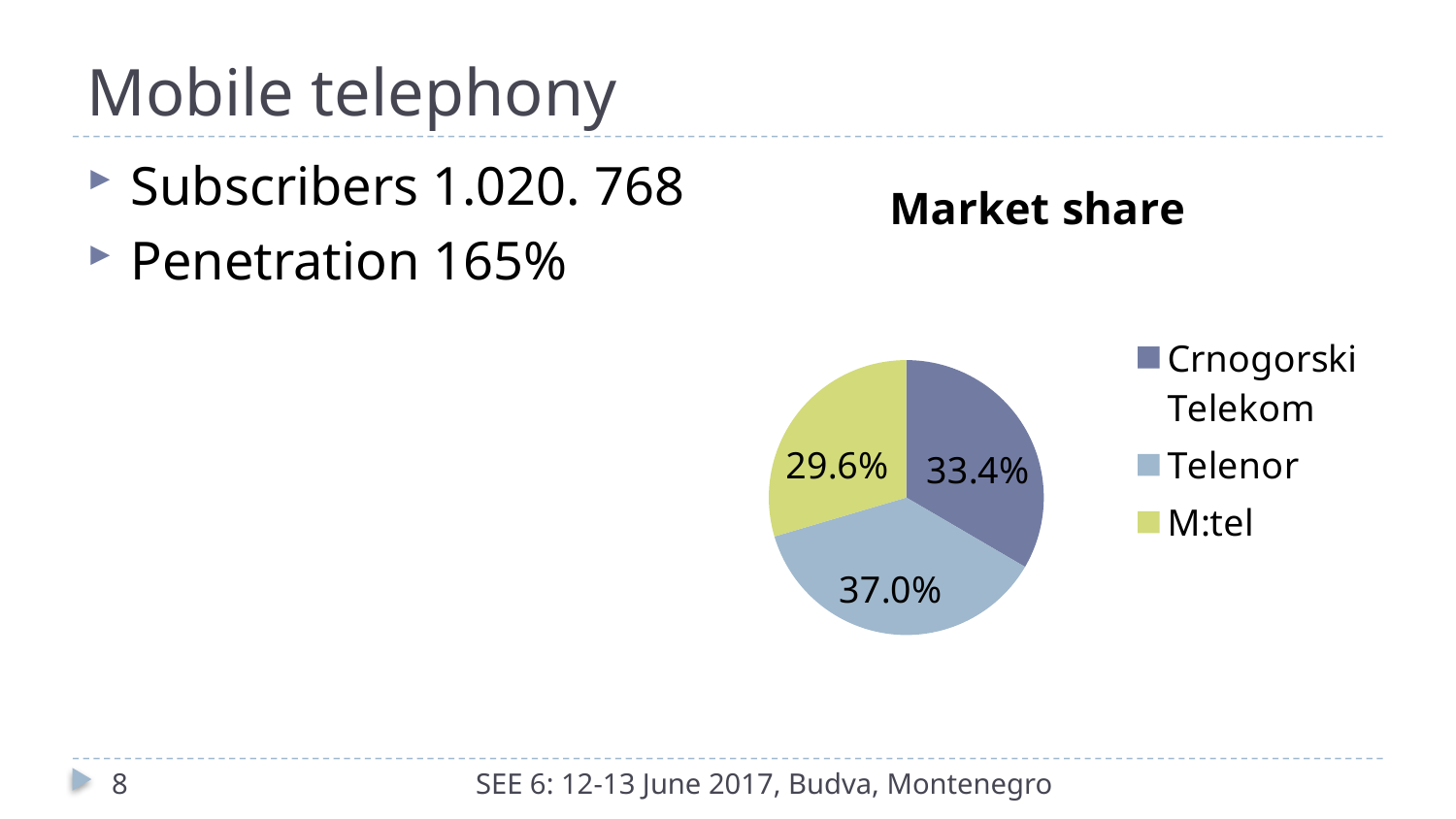
What is the market share of M:tel? 29.6% How many operators are shown in the pie chart? 3 Which operator has the largest market share? Telenor What is the difference in market share between Crnogorski Telekom and M:tel? 3.8% What kind of chart is shown on the slide? Pie chart Which operator has the smallest market share? M:tel What is the difference in market share between Telenor and M:tel? 7.4% Which operator is represented by the yellow-green slice? M:tel What is the title of the chart? Market share What is the market share of Telenor? 37.0% Which has a larger market share, Crnogorski Telekom or Telenor? Telenor What is the market share of Crnogorski Telekom? 33.4%